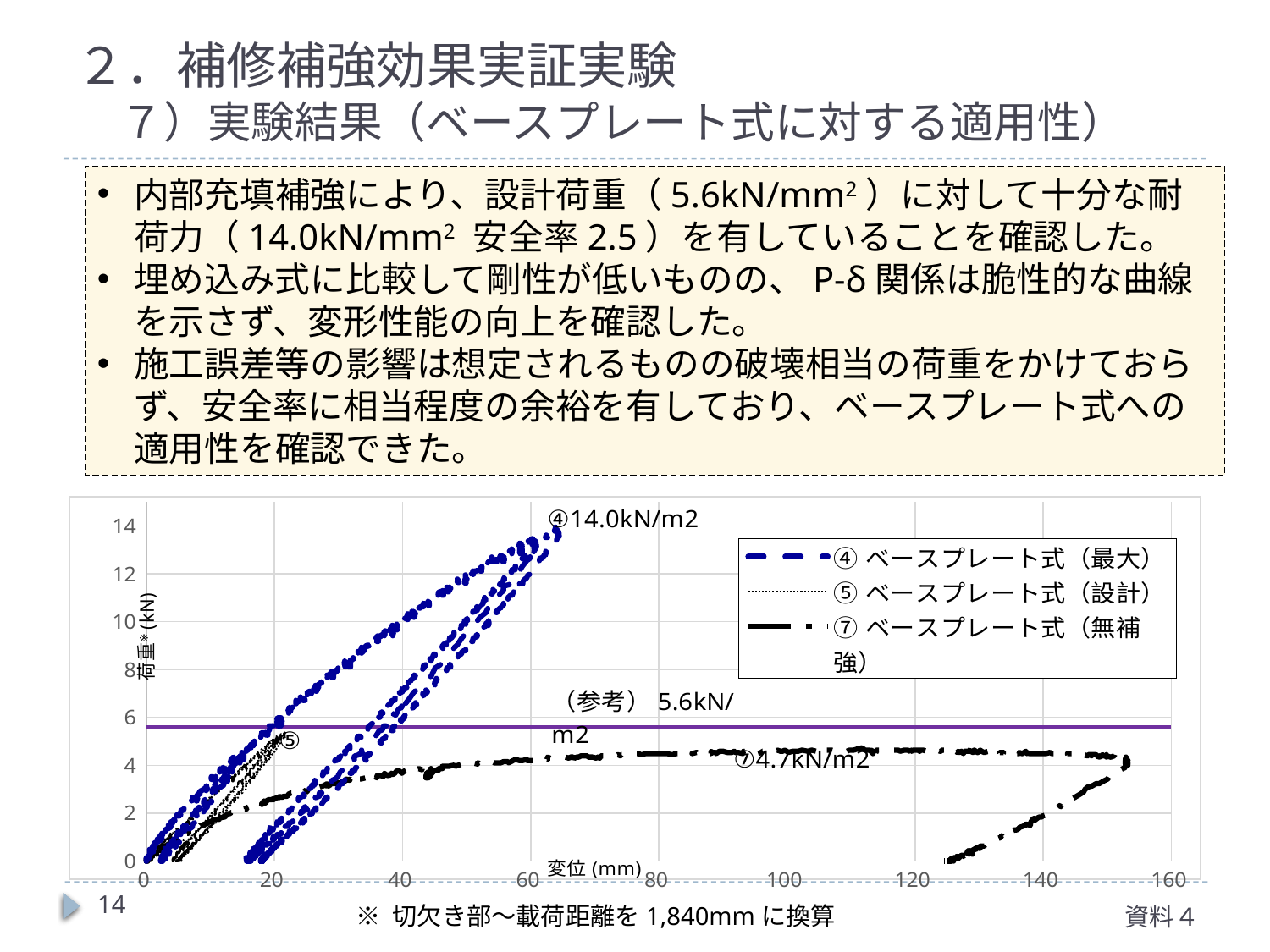
Which series reaches the highest load in the chart? ④ ベースプレート式（最大） What value is labelled on the horizontal reference line marked （参考）? 5.6kN/m2 Which reaches a higher load, series ④ ベースプレート式（最大） or series ⑦ ベースプレート式（無補強）? ④ ベースプレート式（最大） What is the label of the vertical axis? 荷重※ (kN) Is the peak load of series ⑦ ベースプレート式（無補強） greater or less than 6? less What load value is labelled for series ④ ベースプレート式（最大）? 14.0kN/m2 What load value is labelled for series ⑦ ベースプレート式（無補強）? 4.7kN/m2 What kind of chart is shown on the slide? line chart What is the difference between the labelled load of ④ (14.0kN/m2) and the labelled load of ⑦ (4.7kN/m2)? 9.3kN/m2 How many series does the legend list? 3 Is the maximum displacement reached by series ⑦ ベースプレート式（無補強） greater or less than 140? greater What is the label of the horizontal axis? 変位 (mm)